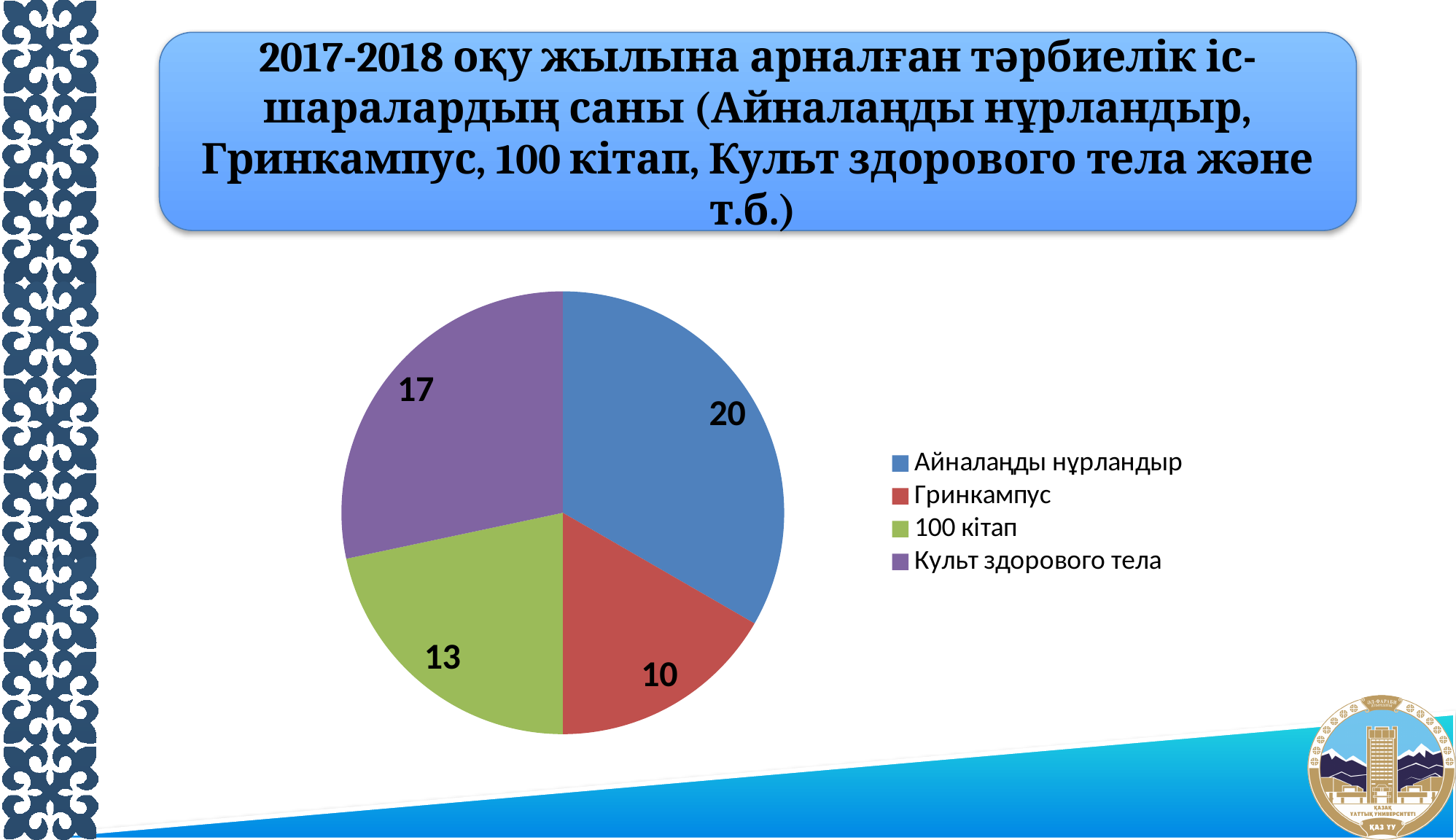
What is the value for Айналаңды нұрландыр? 20 What is the value for 100 кітап? 13 What is the value for Культ здорового тела? 17 What colour is the slice for 100 кітап? green What is the difference between the values for Айналаңды нұрландыр and Гринкампус? 10 How many categories does the pie chart show? 4 Which category has the smallest slice of the pie? Гринкампус What is the value for Гринкампус? 10 Which category has the largest slice of the pie? Айналаңды нұрландыр What is the total of all the slices in the pie chart? 60 Which is larger, the value for Культ здорового тела or the value for 100 кітап? Культ здорового тела What type of chart is shown on the slide? pie chart